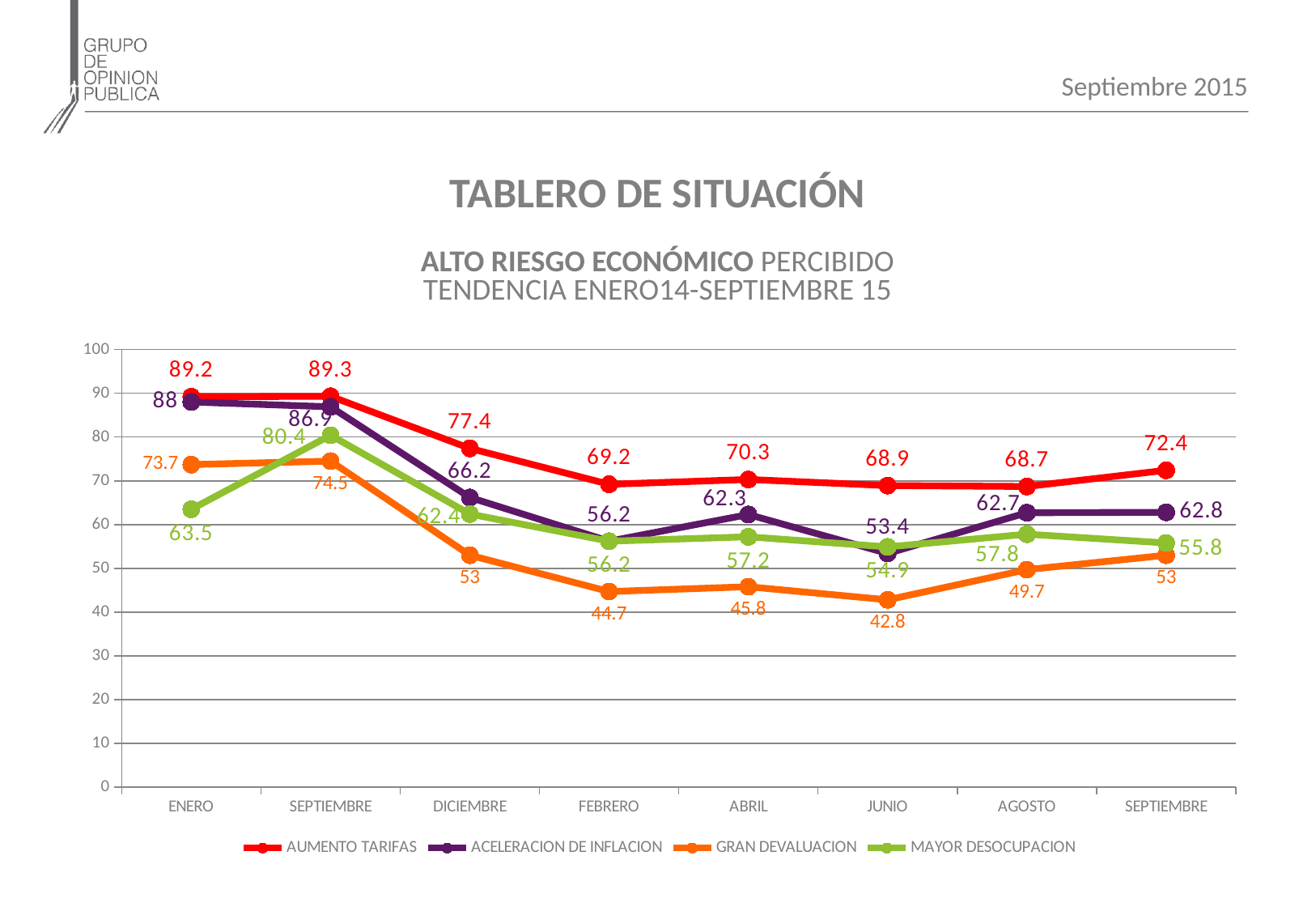
What is the value for GRAN DEVALUACION in JUNIO? 42.8 What is the value for MAYOR DESOCUPACION in ENERO? 63.5 What is the value for ACELERACION DE INFLACION in JUNIO? 53.4 How many time points are plotted along the x axis? 8 Which series has the highest value in ABRIL? AUMENTO TARIFAS Is the value for GRAN DEVALUACION in ABRIL greater or less than 50? less In which month does GRAN DEVALUACION reach its lowest value? JUNIO What is the value for AUMENTO TARIFAS in DICIEMBRE? 77.4 What kind of chart is shown on the slide? line chart How many series does the legend list? 4 What is the difference between AUMENTO TARIFAS and GRAN DEVALUACION in FEBRERO? 24.5 In AGOSTO, which is larger: ACELERACION DE INFLACION or MAYOR DESOCUPACION? ACELERACION DE INFLACION